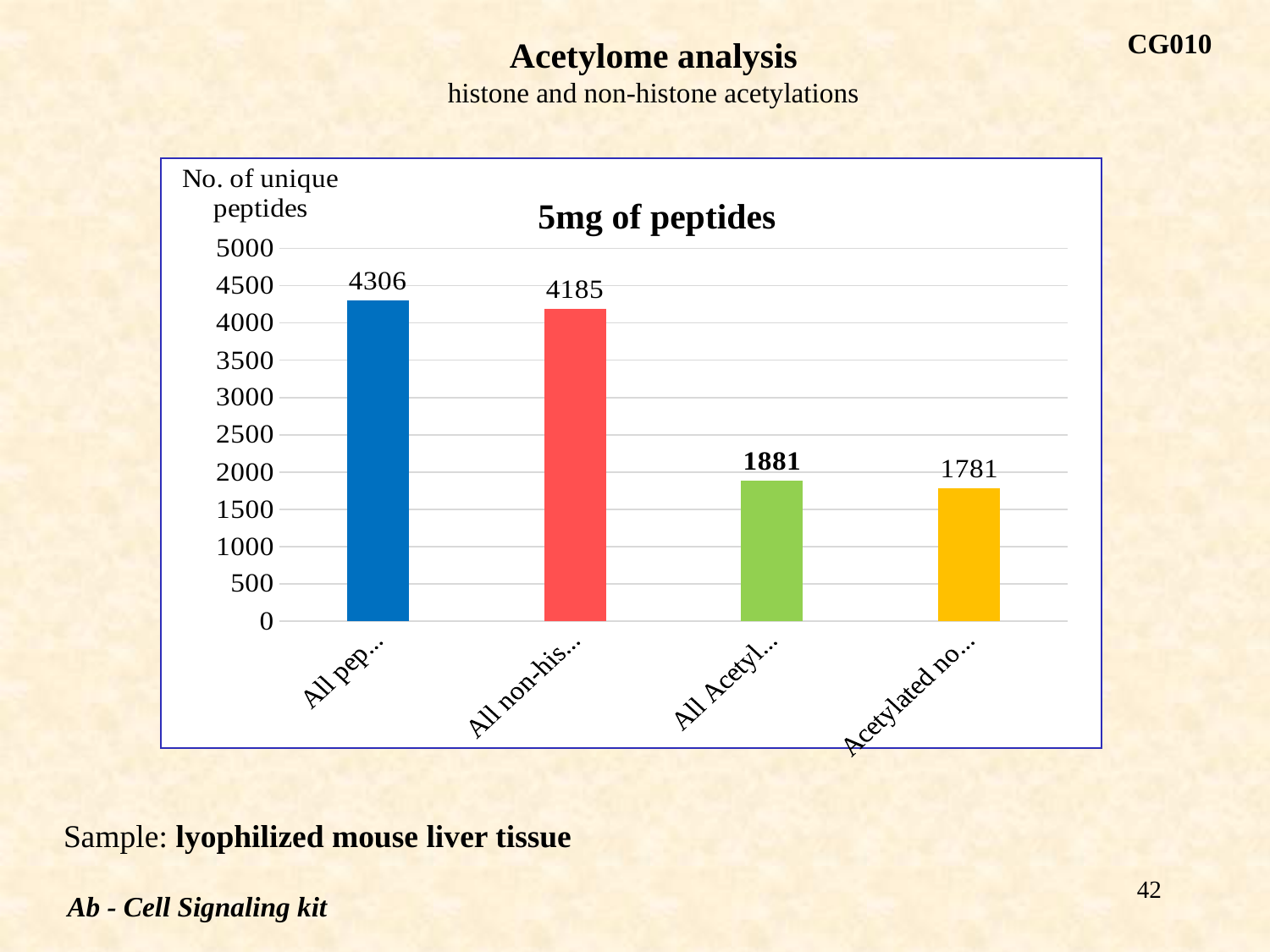
Which bar has the lowest value? Acetylated no... (the fourth, yellow bar) How many bars are plotted in the chart? 4 Which bar has the highest value? All pep... (the first, blue bar) What is the value of the first (blue) bar, labelled "All pep..."? 4306 What type of chart is shown on the slide? bar chart What is the value of the fourth (yellow) bar, labelled "Acetylated no..."? 1781 What is the title of the chart? 5mg of peptides What is the difference between the first bar (4306) and the second bar (4185)? 121 What is the value of the third (green) bar, labelled "All Acetyl..."? 1881 What is the value of the second (red) bar, labelled "All non-his..."? 4185 What is the difference between the third bar (1881) and the fourth bar (1781)? 100 What is the label on the vertical axis? No. of unique peptides